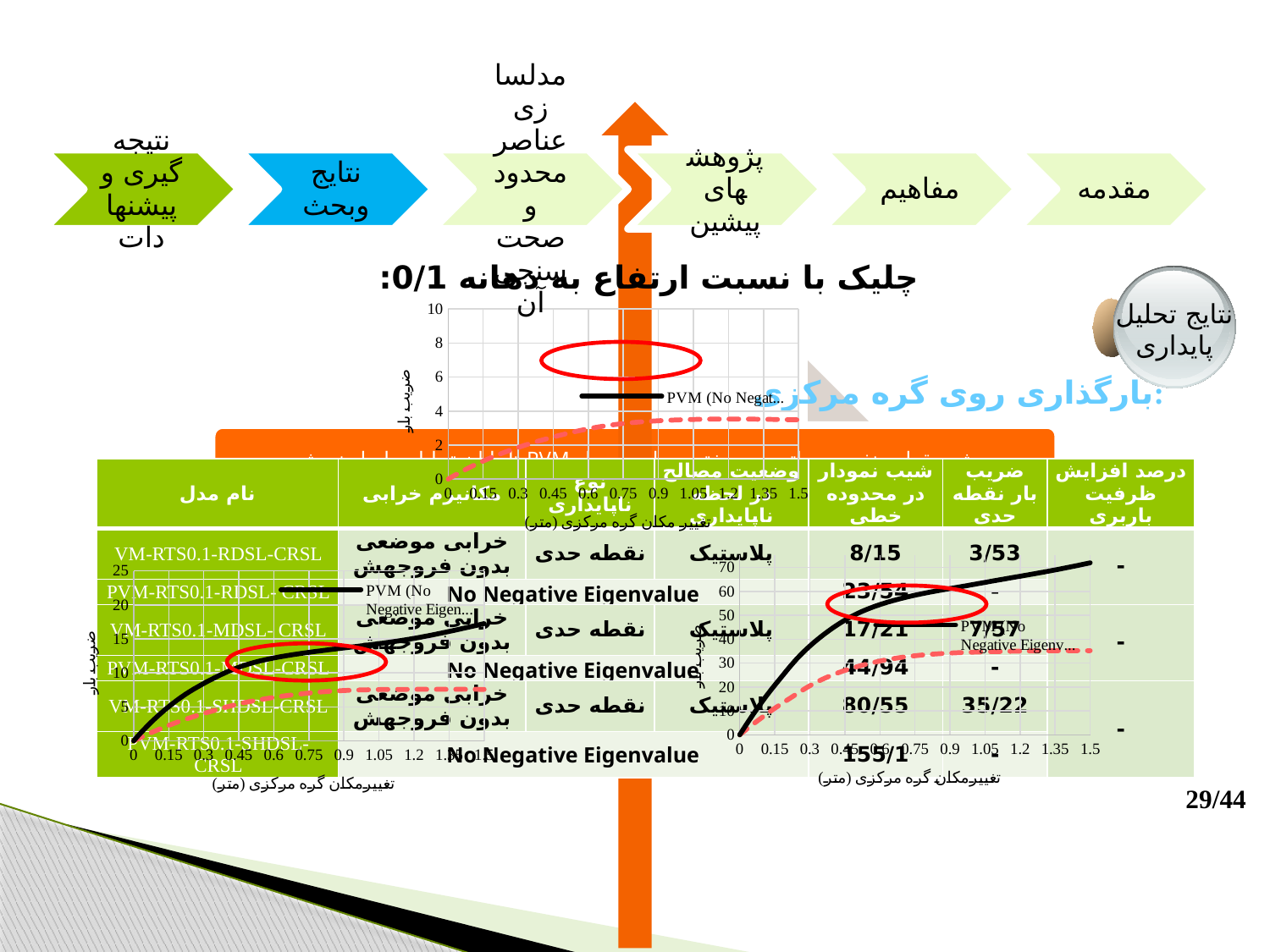
What is the highest value labelled on the y axis of the bottom-right chart? 70 What kind of chart is the bottom-right chart on the slide? line chart How many tick labels are shown on the x axis of the bottom-right chart? 11 How many lines are plotted in the bottom-left chart? 2 In the bottom-left chart, does the pink dashed line rise or fall along the x axis? rise In the bottom-right chart, is the value of the pink dashed line at x = 0.3 greater or less than 40? less In the bottom-right chart, is the value of the black solid line at x = 1.5 greater or less than 50? greater In the bottom-right chart, does the black solid line rise or fall as the x-axis value increases? rise In the bottom-right chart, which line is higher at x = 1.5, the black solid line or the pink dashed line? the black solid line In the bottom-left chart, is the value of the black solid line at x = 1.5 greater or less than 15? greater What is the highest value labelled on the y axis of the bottom-left chart? 25 What kind of chart is the bottom-left chart on the slide? line chart